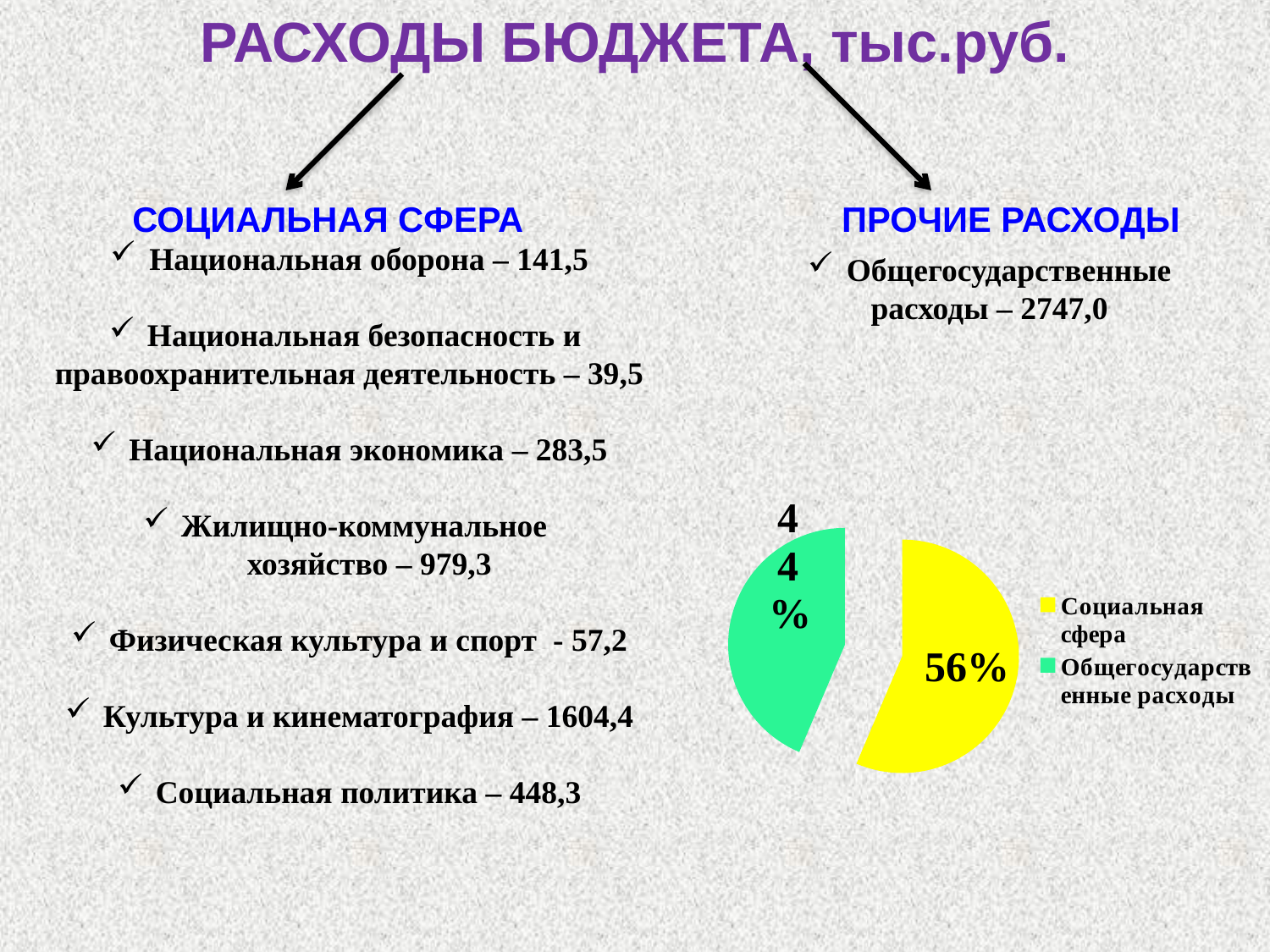
What colour is the "Общегосударственные расходы" slice in the pie chart? Green Which is larger in the pie chart: "Социальная сфера" or "Общегосударственные расходы"? Социальная сфера What colour is the "Социальная сфера" slice in the pie chart? Yellow What kind of chart is shown on the slide? Pie chart Which slice of the pie chart is the largest? Социальная сфера Is the share of "Общегосударственные расходы" in the pie chart greater or less than 50%? less What share of the pie chart does "Общегосударственные расходы" take? 44% How many slices does the pie chart have? 2 Which slice of the pie chart is the smallest? Общегосударственные расходы By how many percentage points does the "Социальная сфера" slice exceed the "Общегосударственные расходы" slice? 12 How many entries does the pie chart legend list? 2 What share of the pie chart does "Социальная сфера" take? 56%